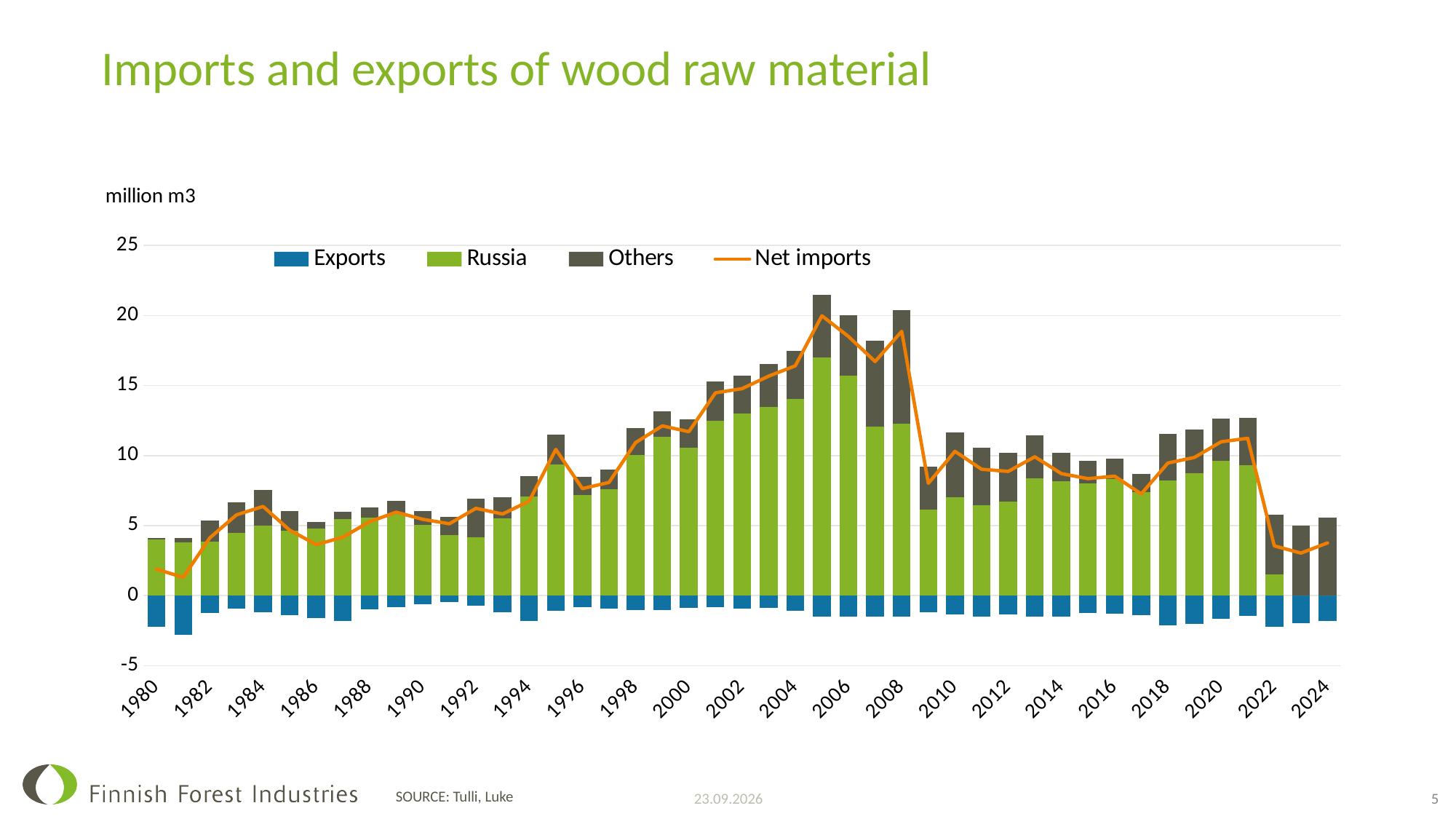
Is the Net imports value for 2009 greater or less than 10? less How many series does the legend list? 4 Is the Net imports value for 2005 greater or less than 15? greater Which year has the larger Net imports value, 2005 or 2010? 2005 How many years (bars) are plotted along the x axis? 45 In which year is the Net imports line at its lowest value? 1981 What kind of chart is shown on the slide? A stacked bar chart combined with a line What unit is shown above the y axis? million m3 Is the Russia value for 2005 greater or less than 15? greater In which year does the Net imports line reach its highest value? 2005 Does the Net imports line rise or fall from 2021 to 2022? fall